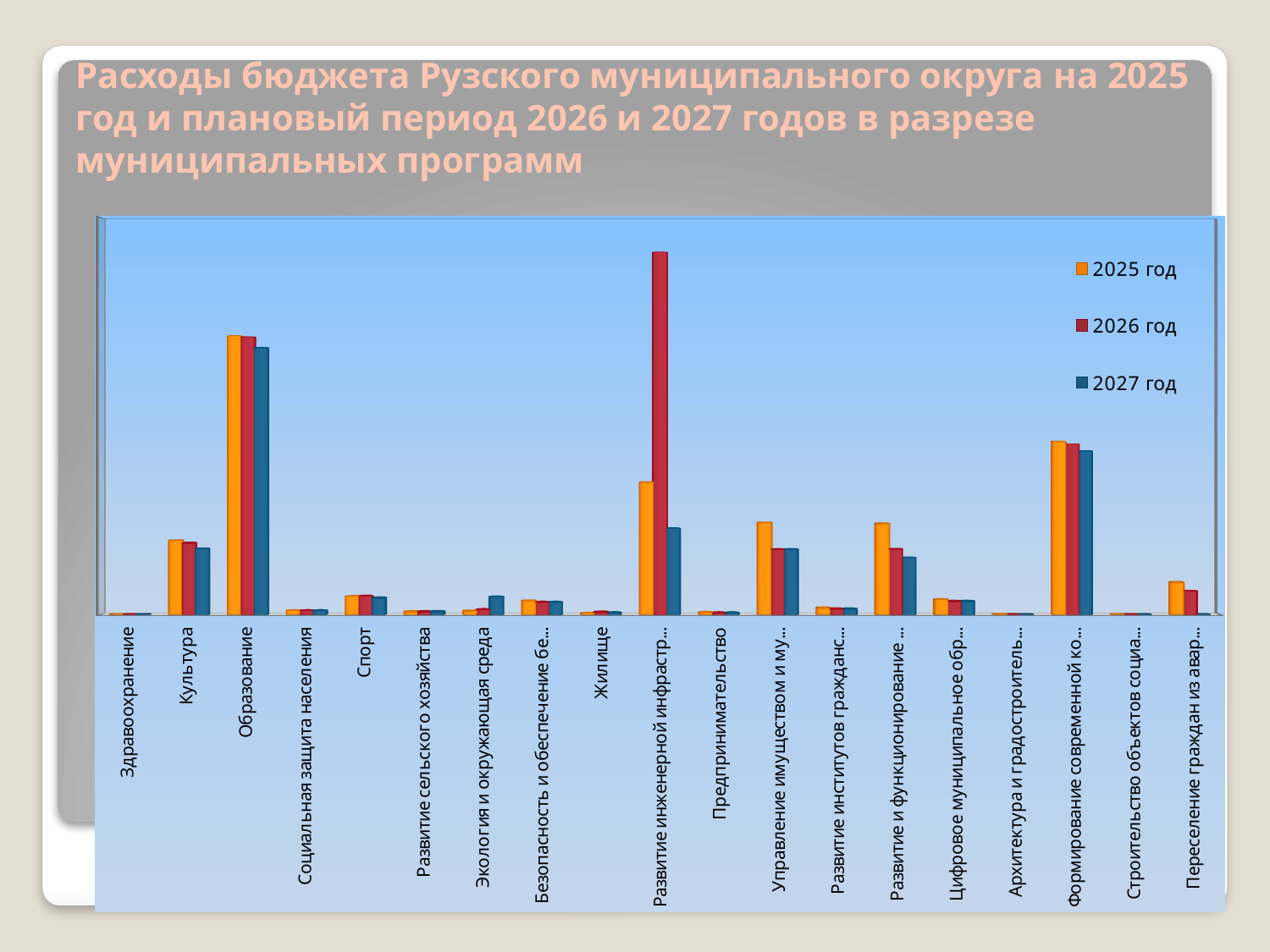
What kind of chart is shown on the slide? Bar chart Which category has the highest value for the 2025 год series? Образование Which colour represents the 2027 год series in the chart? Blue For the 2025 год series, which is larger: Культура or Спорт? Культура For the 2025 год series, which is larger: Образование or Формирование современной ко...? Образование Which category has the highest value for the 2026 год series? Развитие инженерной инфрастр... How many series does the legend list? 3 For Развитие инженерной инфрастр..., which year has the larger value: 2026 год or 2027 год? 2026 год How many categories are shown along the x axis of the chart? 19 Which years are listed in the chart legend? 2025 год, 2026 год, 2027 год Which category has the highest value for the 2027 год series? Образование